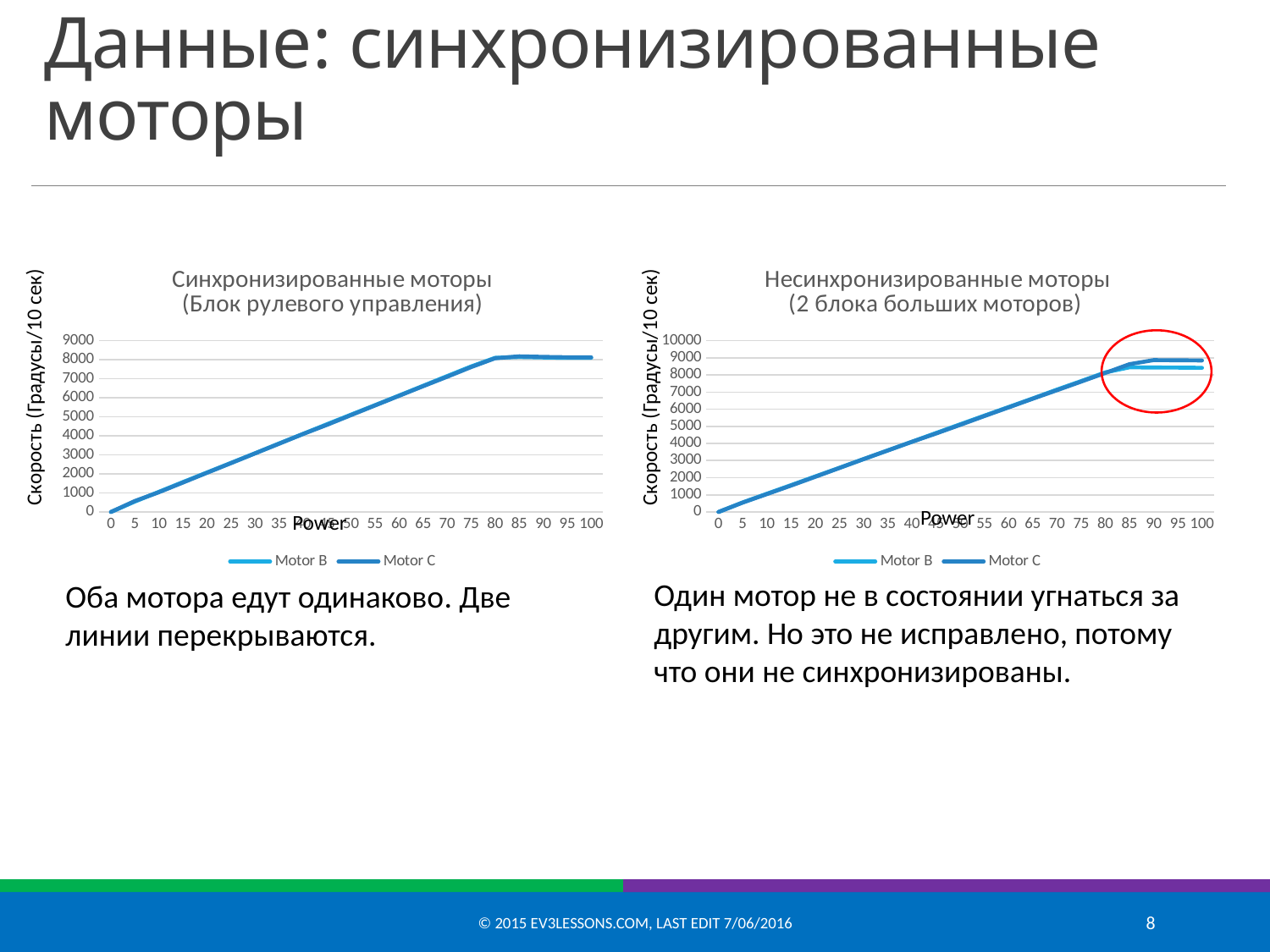
What kind of chart is the left chart titled 'Синхронизированные моторы (Блок рулевого управления)'? line chart In the left chart 'Синхронизированные моторы', do the values rise or fall as Power increases from 0 to 80? rise What is the x-axis title of the right chart 'Несинхронизированные моторы'? Power How many Power tick values are shown on the x axis of the right chart 'Несинхронизированные моторы'? 21 In the left chart 'Синхронизированные моторы', is the value for Motor C at Power 100 greater or less than 7000? greater In the left chart 'Синхронизированные моторы', is the value for Motor B at Power 100 greater or less than 9000? less How many series does the legend of the right chart 'Несинхронизированные моторы' list? 2 In the right chart 'Несинхронизированные моторы', is the value for Motor C at Power 100 greater or less than 8000? greater In the right chart 'Несинхронизированные моторы', which series has the higher value at Power 100, Motor B or Motor C? Motor C What are the legend entries of the left chart 'Синхронизированные моторы'? Motor B, Motor C